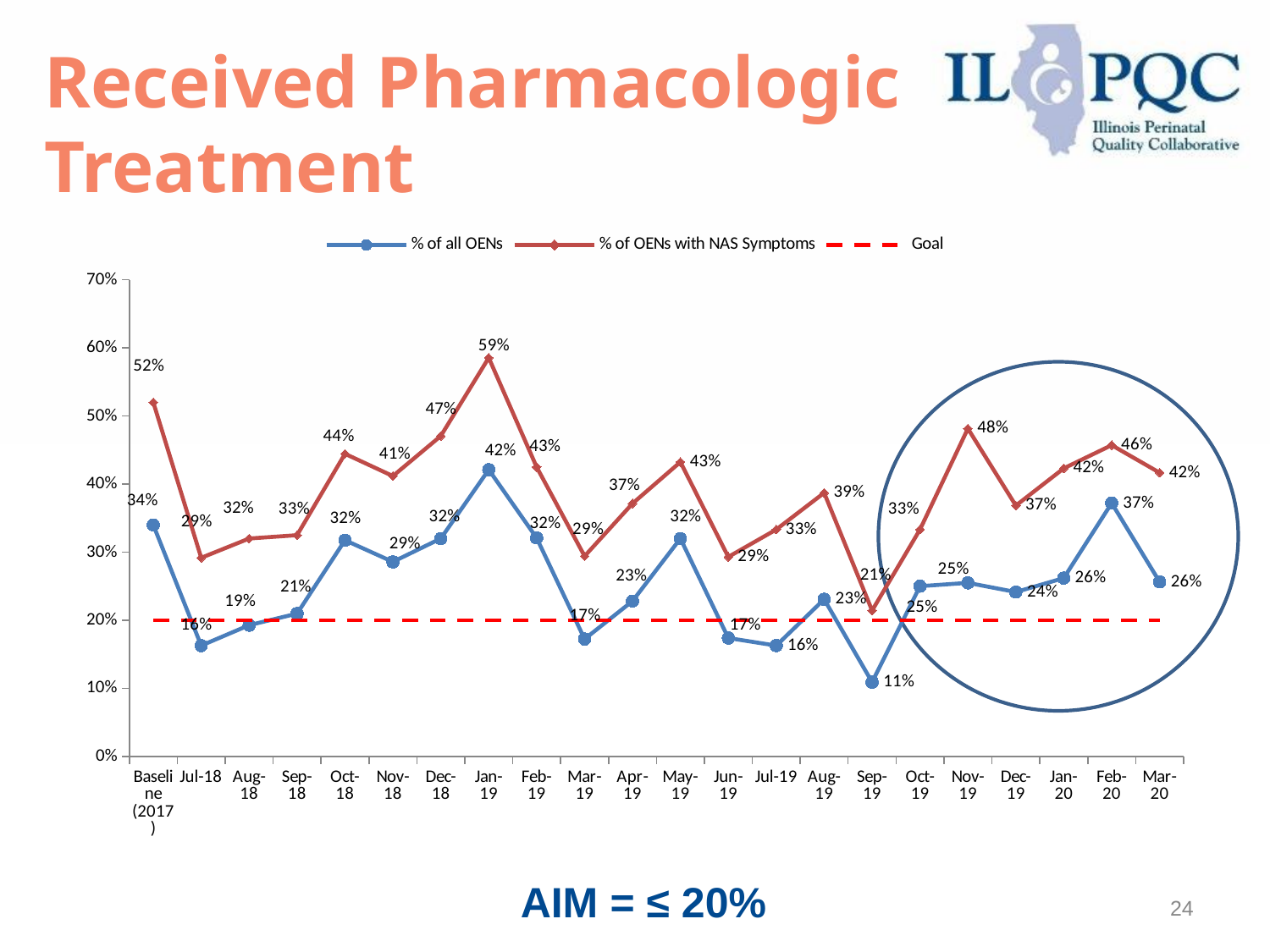
What is the difference between % of all OENs in Jan-19 and Feb-19? 10% What is the value of % of OENs with NAS Symptoms in Mar-20? 42% In which month does % of OENs with NAS Symptoms reach its highest value? Jan-19 Which is larger in Feb-20: % of all OENs or % of OENs with NAS Symptoms? % of OENs with NAS Symptoms In which month is % of all OENs at its lowest? Sep-19 What is the difference between % of OENs with NAS Symptoms and % of all OENs in Nov-19? 23% How many series does the legend list? 3 What is the value of % of OENs with NAS Symptoms in Jan-19? 59% What type of chart is shown on the slide? Line chart What is the value of % of all OENs in Sep-19? 11% What is the value of % of all OENs at Baseline (2017)? 34% At what percentage is the Goal line drawn? 20%